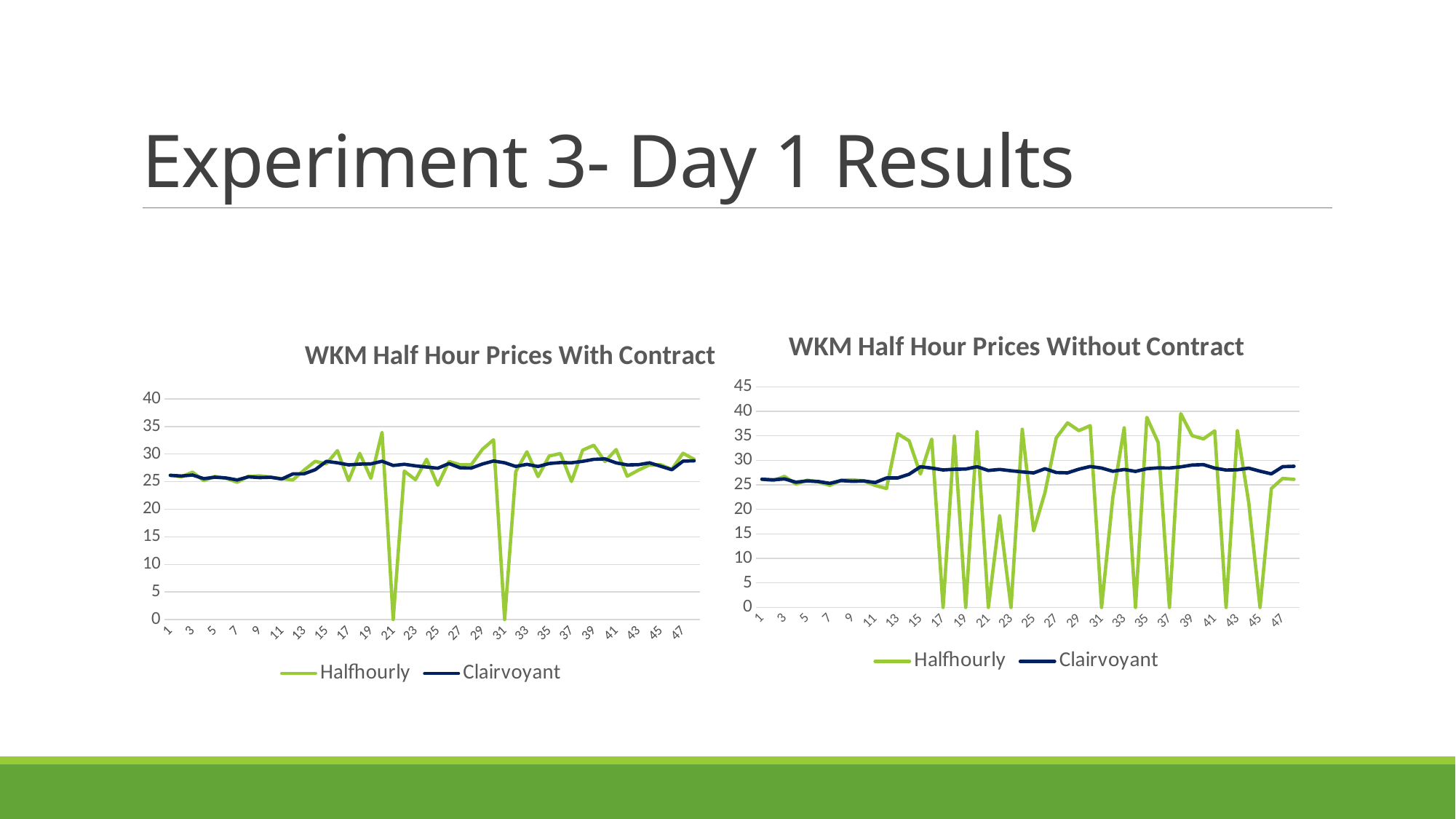
In "WKM Half Hour Prices With Contract", which series has the larger value at point 21, Halfhourly or Clairvoyant? Clairvoyant How many series does the legend of "WKM Half Hour Prices Without Contract" list? 2 In "WKM Half Hour Prices Without Contract", is the Halfhourly value at point 17 greater or less than 5? less In "WKM Half Hour Prices Without Contract", which series has the larger value at point 39, Halfhourly or Clairvoyant? Halfhourly What is the highest value shown on the y axis of "WKM Half Hour Prices Without Contract"? 45 What are the two series named in the legend of "WKM Half Hour Prices With Contract"? Halfhourly and Clairvoyant What kind of chart is "WKM Half Hour Prices With Contract"? line chart In "WKM Half Hour Prices With Contract", is the Clairvoyant value at point 1 greater or less than 20? greater In "WKM Half Hour Prices With Contract", is the Halfhourly value at point 31 greater or less than 10? less In "WKM Half Hour Prices With Contract", does the Clairvoyant line generally rise or fall from point 1 to point 47? rise